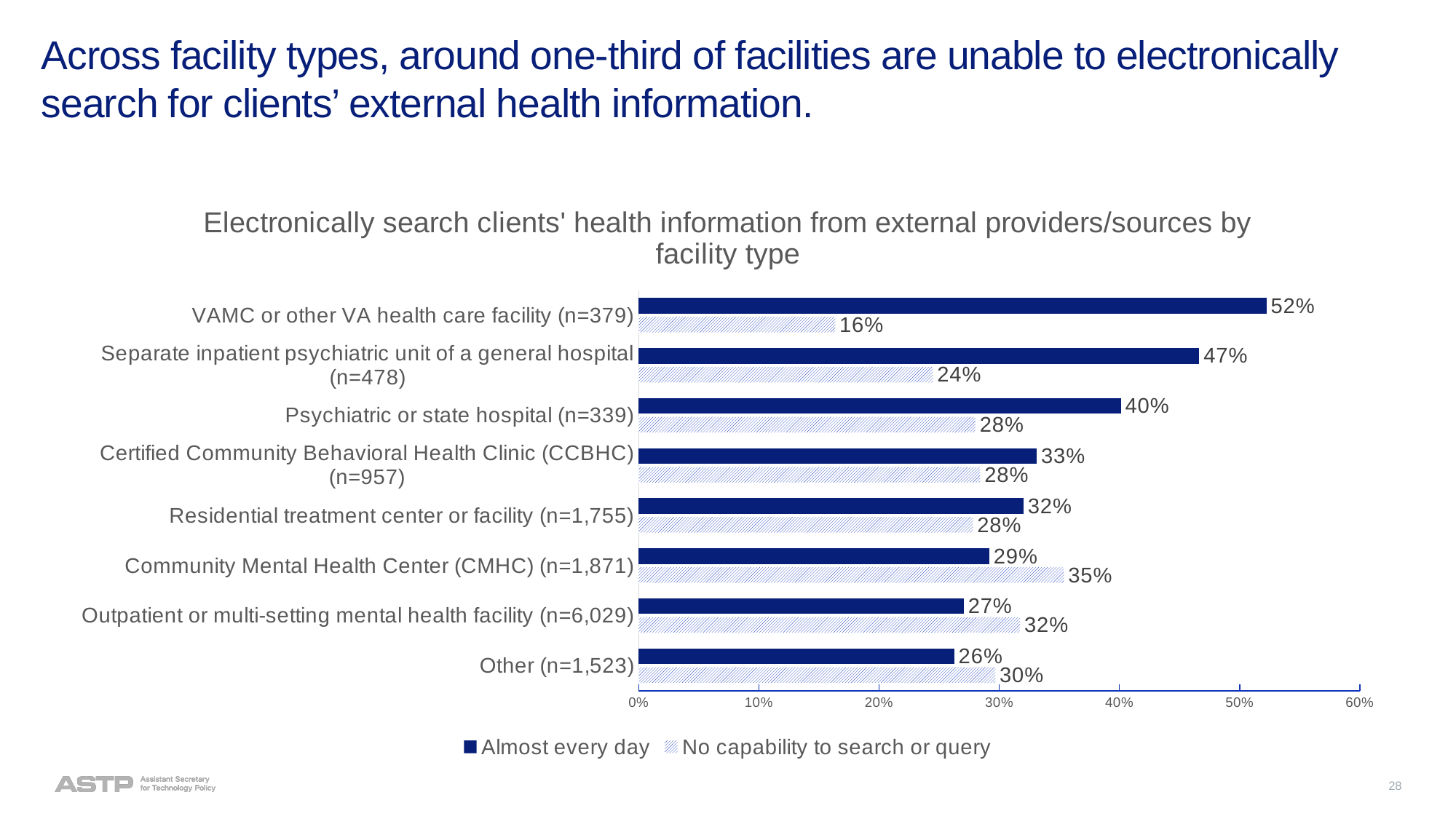
How many series does the legend list? 2 What is the difference between the 'Almost every day' and 'No capability to search or query' values for VAMC or other VA health care facility (n=379)? 36% What is the 'No capability to search or query' value for Community Mental Health Center (CMHC) (n=1,871)? 35% What is the 'Almost every day' value for Psychiatric or state hospital (n=339)? 40% For Outpatient or multi-setting mental health facility (n=6,029), which is larger: 'Almost every day' or 'No capability to search or query'? No capability to search or query How many facility types are shown in the chart? 8 Which facility type has the highest 'Almost every day' value? VAMC or other VA health care facility (n=379) What is the title of the chart? Electronically search clients' health information from external providers/sources by facility type What kind of chart is shown on the slide? Bar chart Which facility type has the lowest 'No capability to search or query' value? VAMC or other VA health care facility (n=379) What is the 'Almost every day' value for VAMC or other VA health care facility (n=379)? 52% What is the 'No capability to search or query' value for Other (n=1,523)? 30%